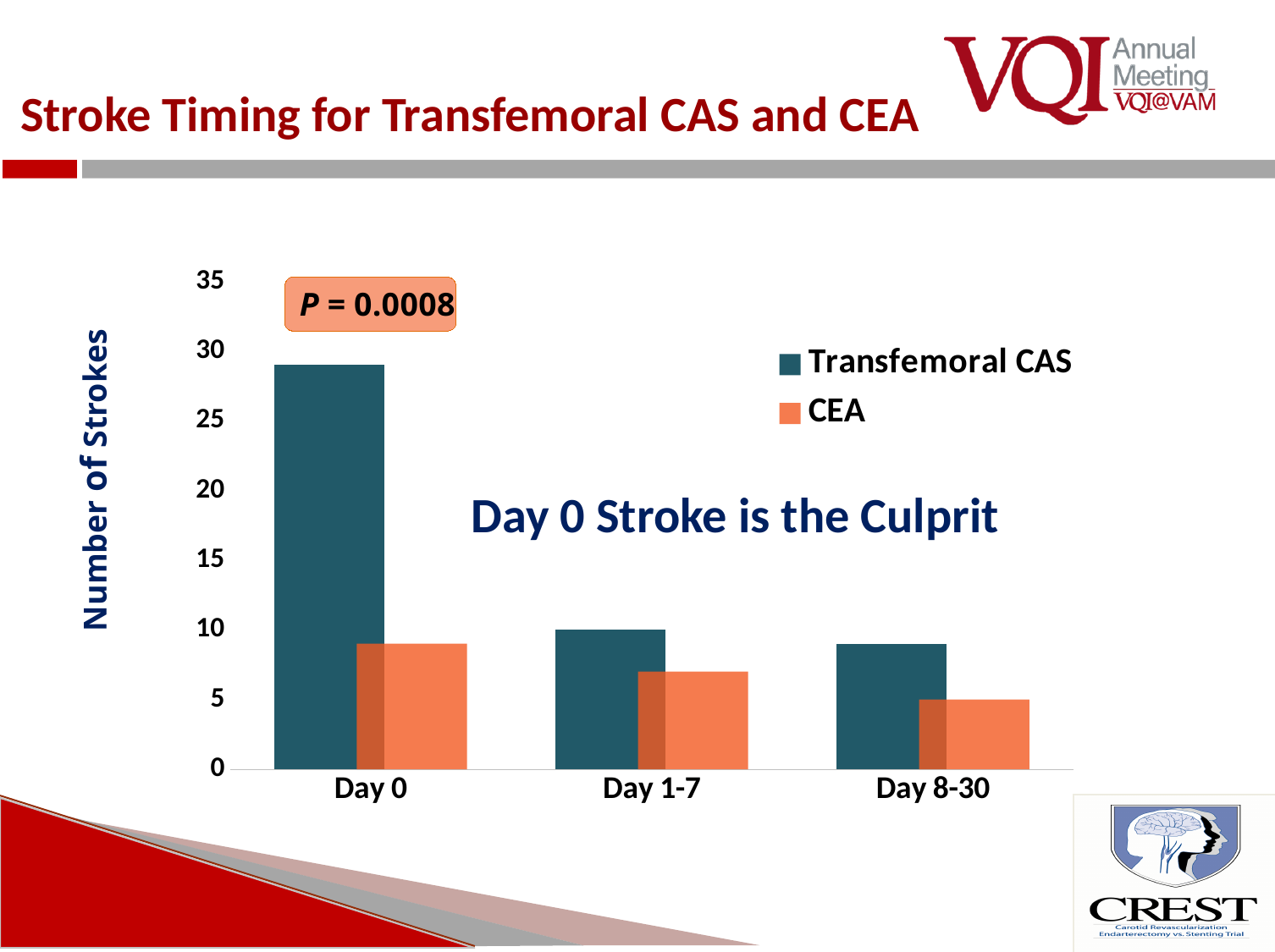
How many categories are shown on the x axis? 3 At Day 0, which series has the larger value, Transfemoral CAS or CEA? Transfemoral CAS For which category is the CEA value lowest? Day 8-30 Do the Transfemoral CAS values rise or fall from Day 0 to Day 8-30? fall Is the Transfemoral CAS value for Day 0 greater or less than 25? greater How many series does the legend list? 2 For which category is the CEA value highest? Day 0 For which category is the Transfemoral CAS value highest? Day 0 What is the title of the y axis? Number of Strokes Is the CEA value for Day 8-30 greater or less than 10? less What kind of chart is shown on the slide? bar chart Is the CEA value for Day 0 greater or less than 15? less